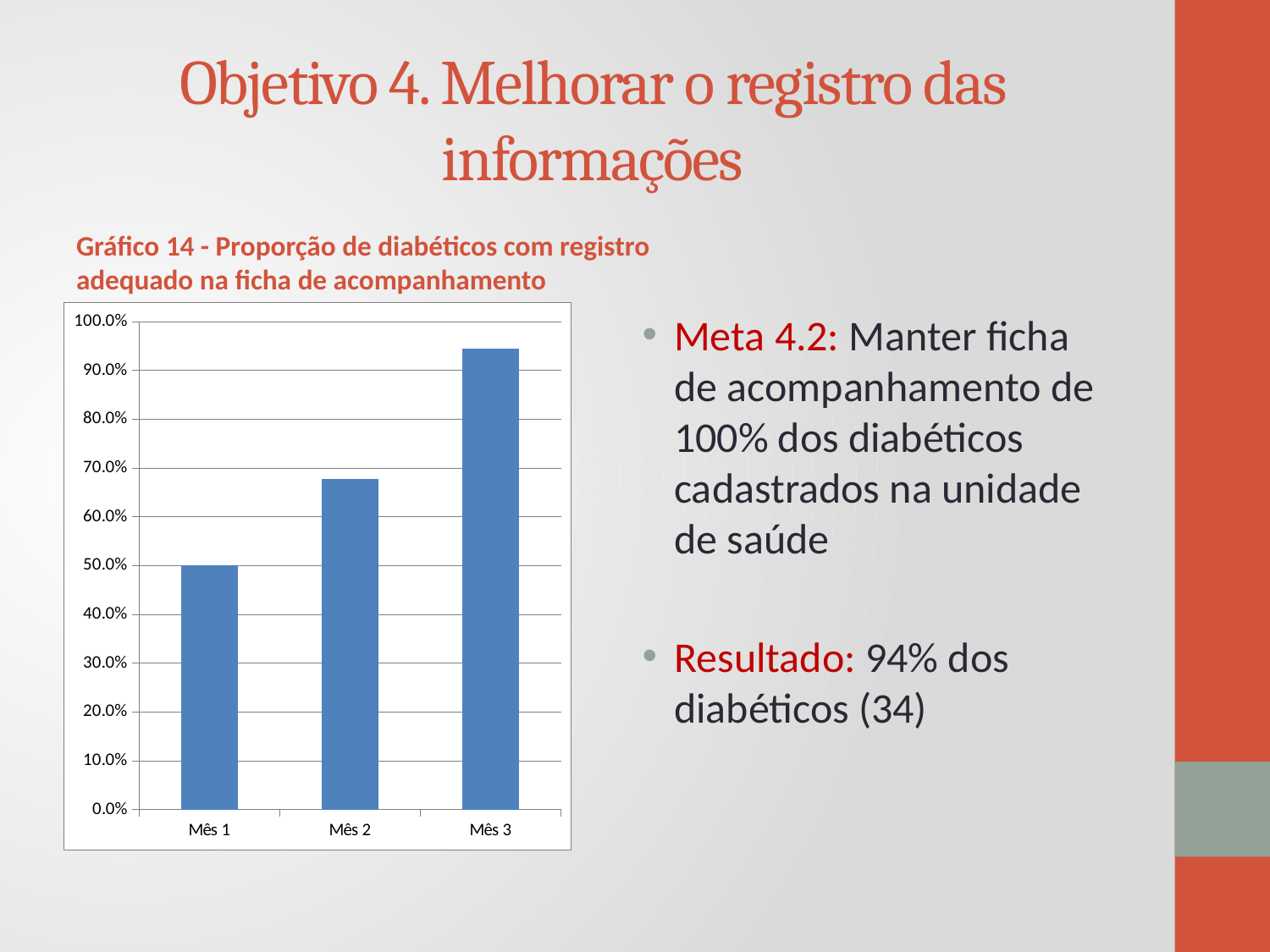
Is the value for Mês 3 greater or less than 90.0%? greater Which month has the lowest proportion in the chart? Mês 1 What is the title of the chart on the slide? Gráfico 14 - Proporção de diabéticos com registro adequado na ficha de acompanhamento Is the value for Mês 2 greater or less than 60.0%? greater What is the value for Mês 1 in the chart? 50.0% Do the values rise or fall from Mês 1 to Mês 3? rise How many categories are plotted on the x axis of the chart? 3 Which is larger, the value for Mês 2 or the value for Mês 3? Mês 3 Is the value for Mês 2 greater or less than 70.0%? less What kind of chart is shown on the slide? bar chart What is the highest value shown on the y axis of the chart? 100.0% Which month has the highest proportion in the chart? Mês 3